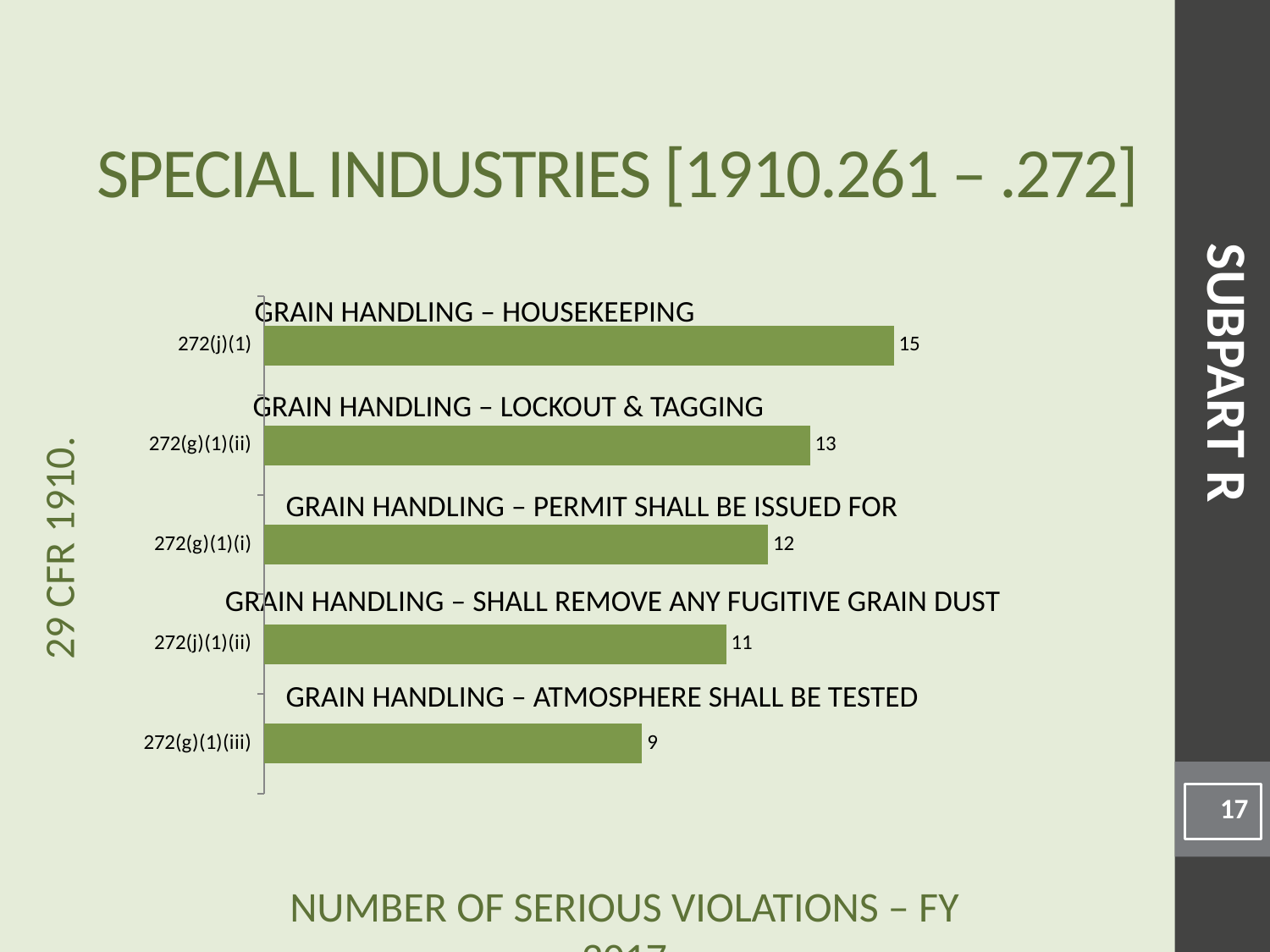
What is the number of serious violations for 272(g)(1)(ii) (Grain Handling – Lockout & Tagging)? 13 What is the total number of serious violations across all five standards shown? 60 What is the number of serious violations for 272(g)(1)(i) (Grain Handling – Permit Shall Be Issued For)? 12 What is the number of serious violations for 272(j)(1) (Grain Handling – Housekeeping)? 15 What is the number of serious violations for 272(j)(1)(ii) (Grain Handling – Shall Remove Any Fugitive Grain Dust)? 11 Which standard has the highest number of serious violations? 272(j)(1) What is the number of serious violations for 272(g)(1)(iii) (Grain Handling – Atmosphere Shall Be Tested)? 9 How many standards are shown in the chart? 5 What type of chart is shown on the slide? Bar chart Which standard has the lowest number of serious violations? 272(g)(1)(iii) Which has more serious violations, 272(g)(1)(ii) or 272(j)(1)(ii)? 272(g)(1)(ii) What is the difference in serious violations between 272(j)(1) and 272(g)(1)(iii)? 6